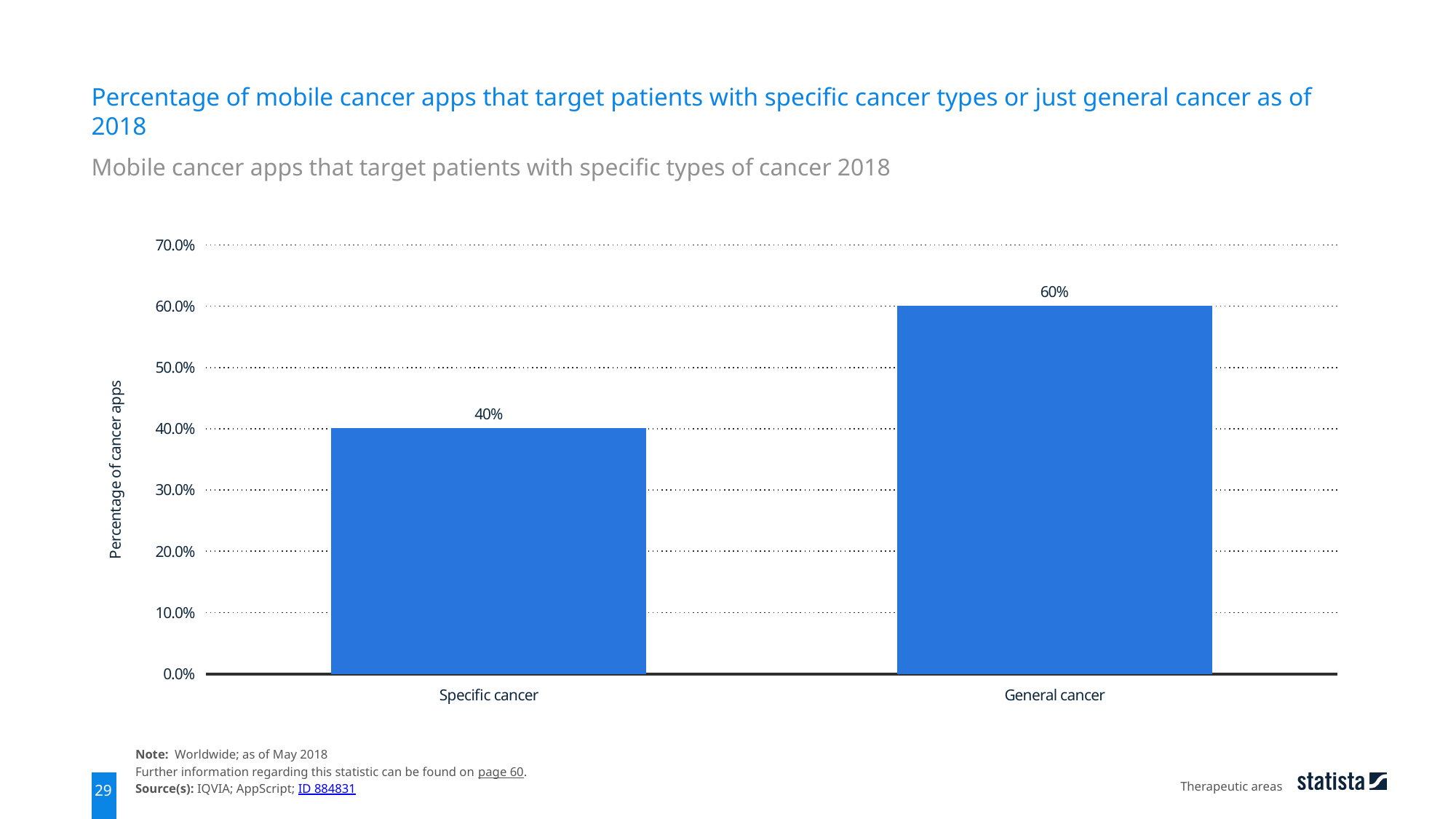
Is the value for Specific cancer greater or less than 50.0%? less What kind of chart is shown on the slide? Bar chart Is the value for General cancer greater or less than 50.0%? greater Which is larger, the value for Specific cancer or the value for General cancer? General cancer What is the difference between the values for General cancer and Specific cancer? 20% How many categories are shown on the x axis? 2 What is the highest value shown on the y axis? 70.0% Which category has the highest value? General cancer What is the label of the y axis? Percentage of cancer apps What is the value for Specific cancer? 40% Which category has the lowest value? Specific cancer What is the value for General cancer? 60%